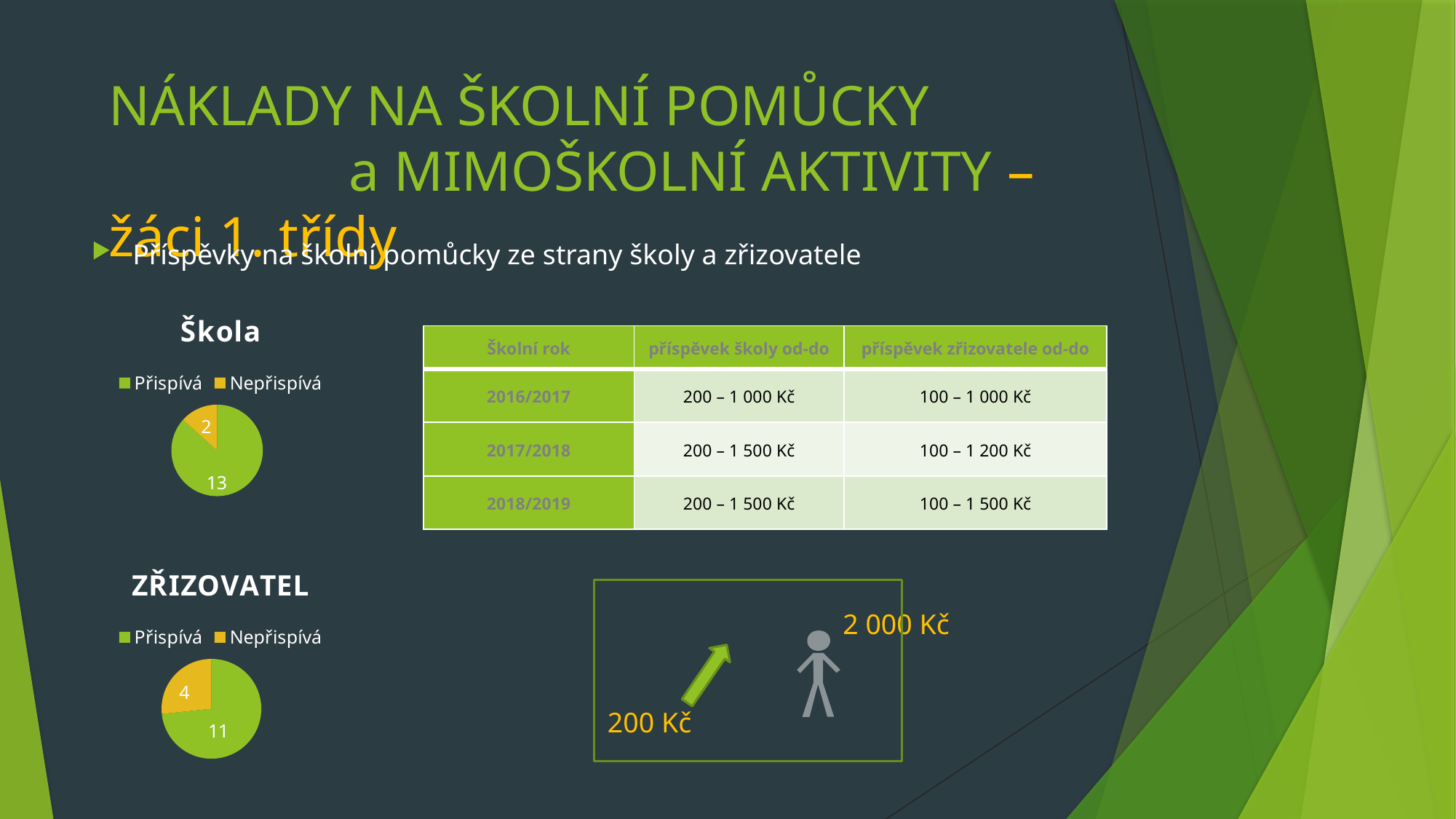
In the Škola chart, what is the difference between Přispívá and Nepřispívá? 11 In the ZŘIZOVATEL chart, what is the value for Nepřispívá? 4 In the Škola chart, what is the value for Nepřispívá? 2 In the ZŘIZOVATEL chart, which slice is the smallest? Nepřispívá In the Škola chart, what is the value for Přispívá? 13 In the ZŘIZOVATEL chart, what is the value for Přispívá? 11 What type of chart is the Škola chart? Pie chart In the ZŘIZOVATEL chart, what is the difference between Přispívá and Nepřispívá? 7 Which is larger: Nepřispívá in the Škola chart or Nepřispívá in the ZŘIZOVATEL chart? Nepřispívá in the ZŘIZOVATEL chart How many entries does the legend of the ZŘIZOVATEL chart list? 2 In the Škola chart, which slice is the largest? Přispívá What colour is the Nepřispívá slice in the Škola chart? Orange